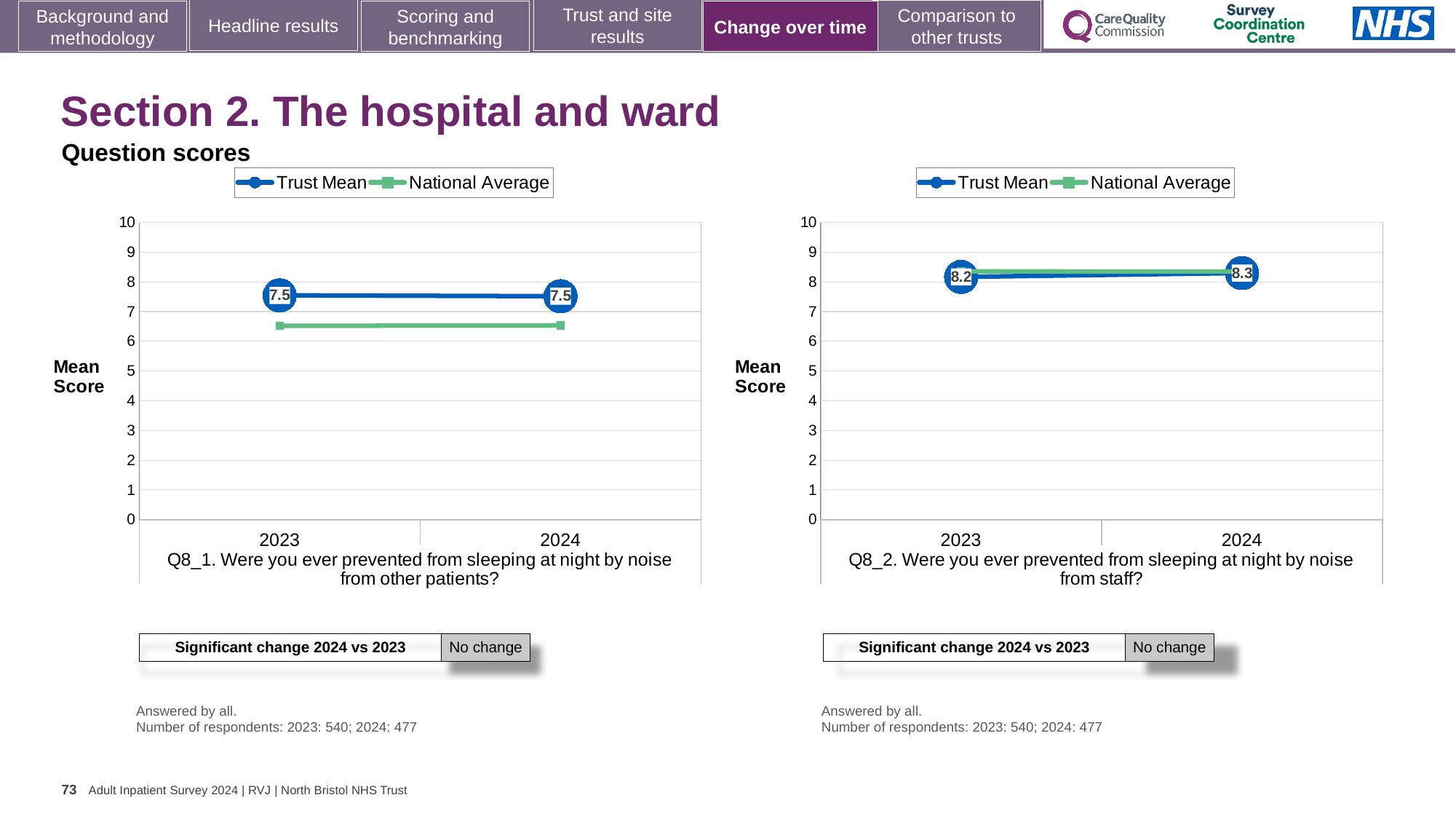
In the Q8_2 chart (right), is the National Average for 2024 greater or less than 8? greater In the Q8_2 chart (right), does the Trust Mean rise or fall from 2023 to 2024? rise In the Q8_1 chart (left), is the National Average for 2023 greater or less than 7? less What type of chart is the Q8_1 chart (left)? line chart In the Q8_1 chart (left), what is the Trust Mean for 2023? 7.5 In the Q8_2 chart (right), what is the difference between the Trust Mean for 2024 and 2023? 0.1 In the Q8_1 chart (left), is the Trust Mean or the National Average higher in 2024? Trust Mean In the Q8_1 chart (left), what is the Trust Mean for 2024? 7.5 In the Q8_2 chart (right), what is the Trust Mean for 2023? 8.2 How many years are shown on the x axis of the Q8_1 chart (left)? 2 How many series does the legend of the Q8_2 chart (right) list? 2 In the Q8_2 chart (right), what is the Trust Mean for 2024? 8.3